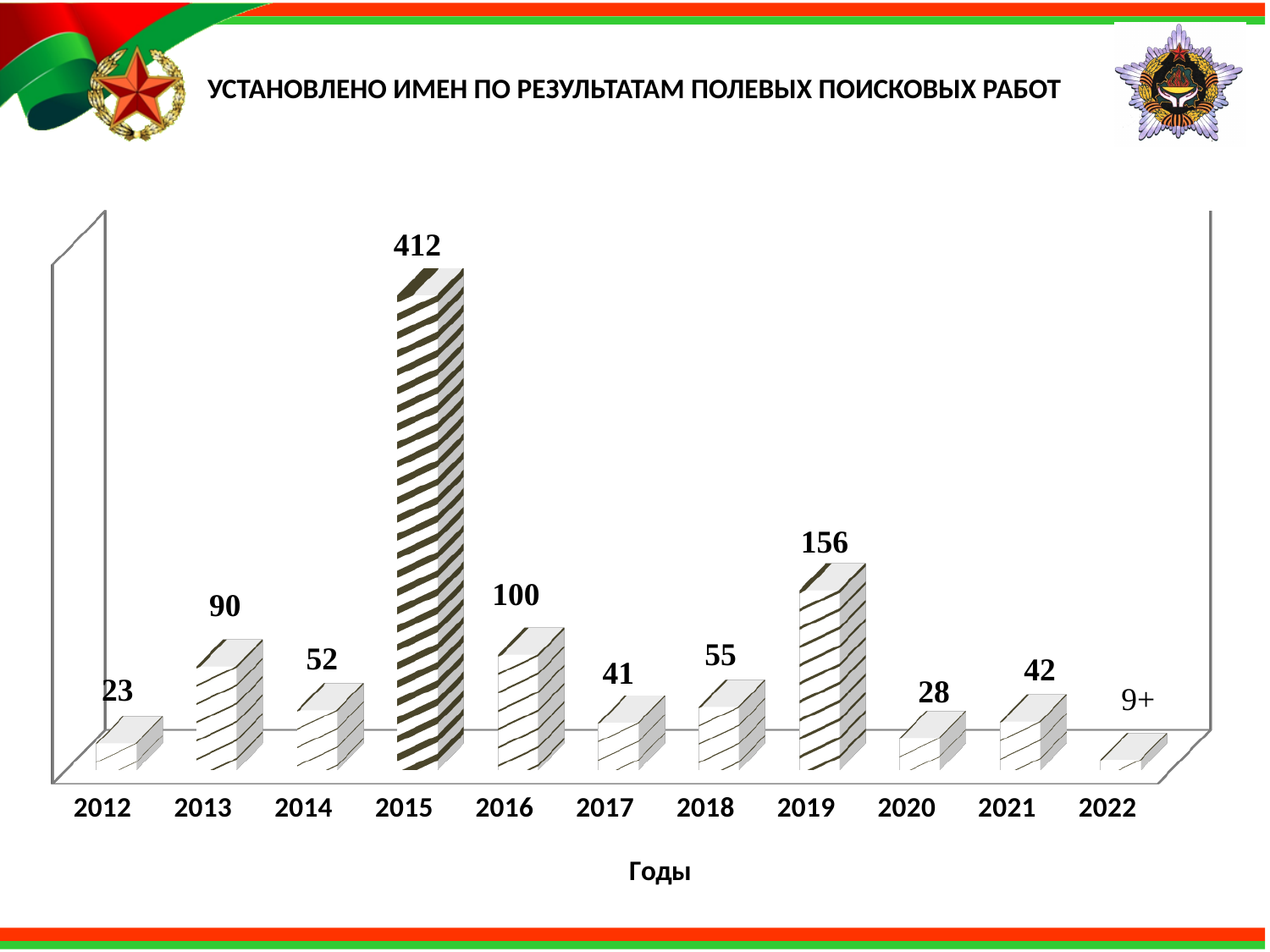
What kind of chart is this? bar chart What is the label of the x axis? Годы What is the value for 2015? 412 Which is larger, the value for 2016 or the value for 2018? 2016 What is the value shown for 2022? 9+ What is the value for 2012? 23 What is the value for 2019? 156 What is the difference between the values for 2015 and 2019? 256 What is the difference between the values for 2013 and 2014? 38 How many years are shown on the x axis? 11 Which year has the lowest value? 2022 Which year has the highest value? 2015